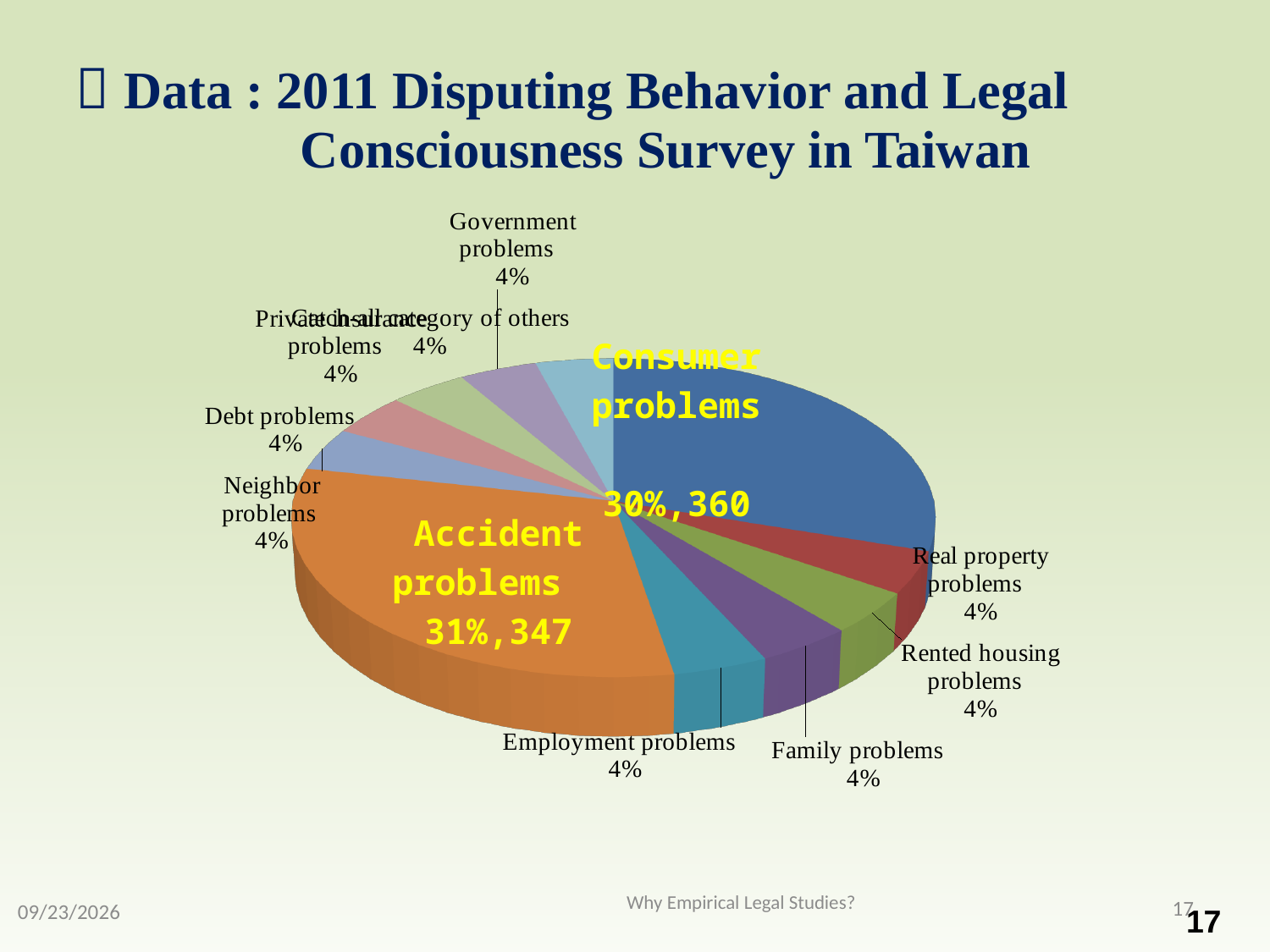
What percentage is shown for Debt problems? 4% What colour is the Consumer problems slice? blue What count is printed for Consumer problems? 360 What percentage of the pie is labelled for Consumer problems? 30% What percentage is shown for Employment problems? 4% What kind of chart is shown on the slide? pie chart What percentage is shown for Family problems? 4% Which slice is larger, Consumer problems or Real property problems? Consumer problems What count is printed for Accident problems? 347 What percentage is shown for Government problems? 4% Which category has the highest percentage label on the pie? Accident problems What is the difference between the counts printed for Consumer problems and Accident problems? 13